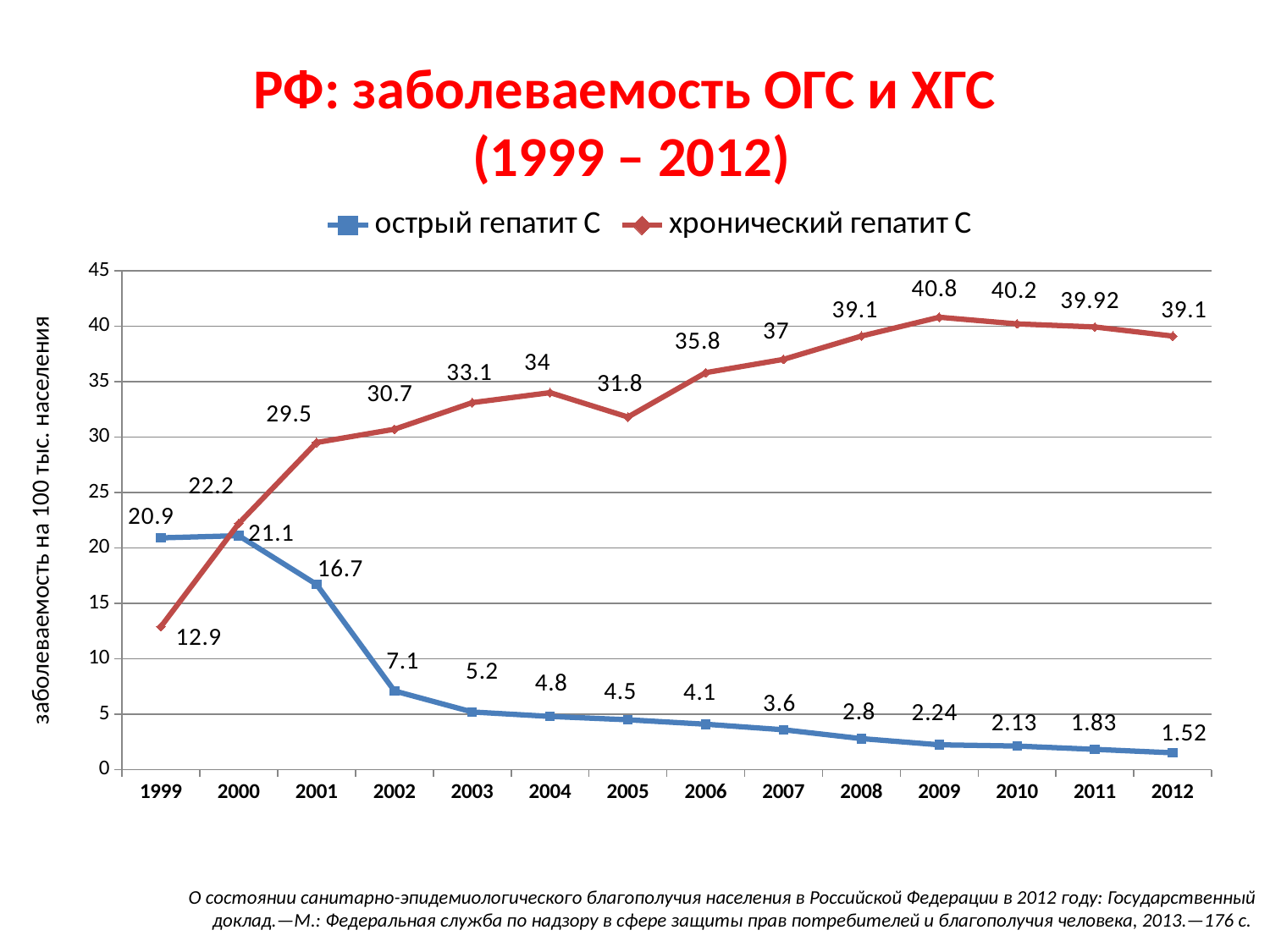
Which series has the larger value in 1999, острый гепатит С or хронический гепатит С? острый гепатит С In which year is острый гепатит С at its lowest value? 2012 What is the difference between хронический гепатит С and острый гепатит С in 2012? 37.58 What is the value for острый гепатит С in 2002? 7.1 Does the value for острый гепатит С rise or fall from 2001 to 2012? fall How many series does the legend list? 2 What is the label of the y axis? заболеваемость на 100 тыс. населения How many years are plotted along the x axis? 14 What type of chart is shown on the slide? line chart What is the value for хронический гепатит С in 2011? 39.92 Is the value for хронический гепатит С in 2005 greater or less than 30? greater In which year does хронический гепатит С reach its highest value? 2009